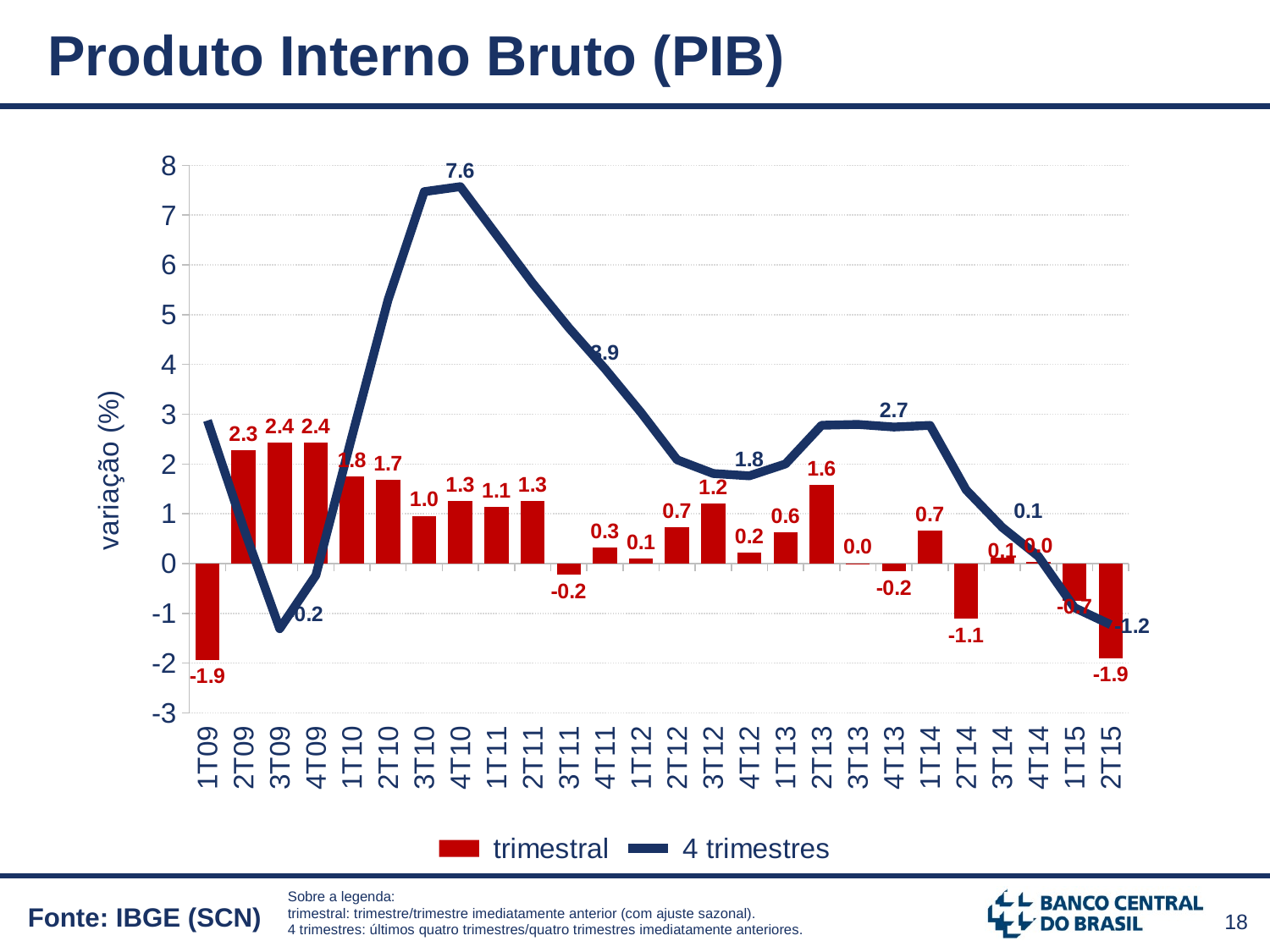
What is the difference between the trimestral values for 2T13 and 1T13? 1.0 Which has the larger trimestral value, 2T09 or 1T10? 2T09 What is the value of the 4 trimestres series at 4T13? 2.7 At which quarter does the 4 trimestres line reach its highest value? 4T10 Is the value of the 4 trimestres line at 3T10 greater or less than 7? greater Does the 4 trimestres line rise or fall between 4T10 and 4T12? fall What is the value of the 4 trimestres series at 4T10? 7.6 What is the trimestral value for 2T14? -1.1 What is the value of the trimestral series for 4T10? 1.3 How many series does the legend list? 2 How many quarters are shown on the x axis? 26 What is the lowest value shown for the trimestral series? -1.9